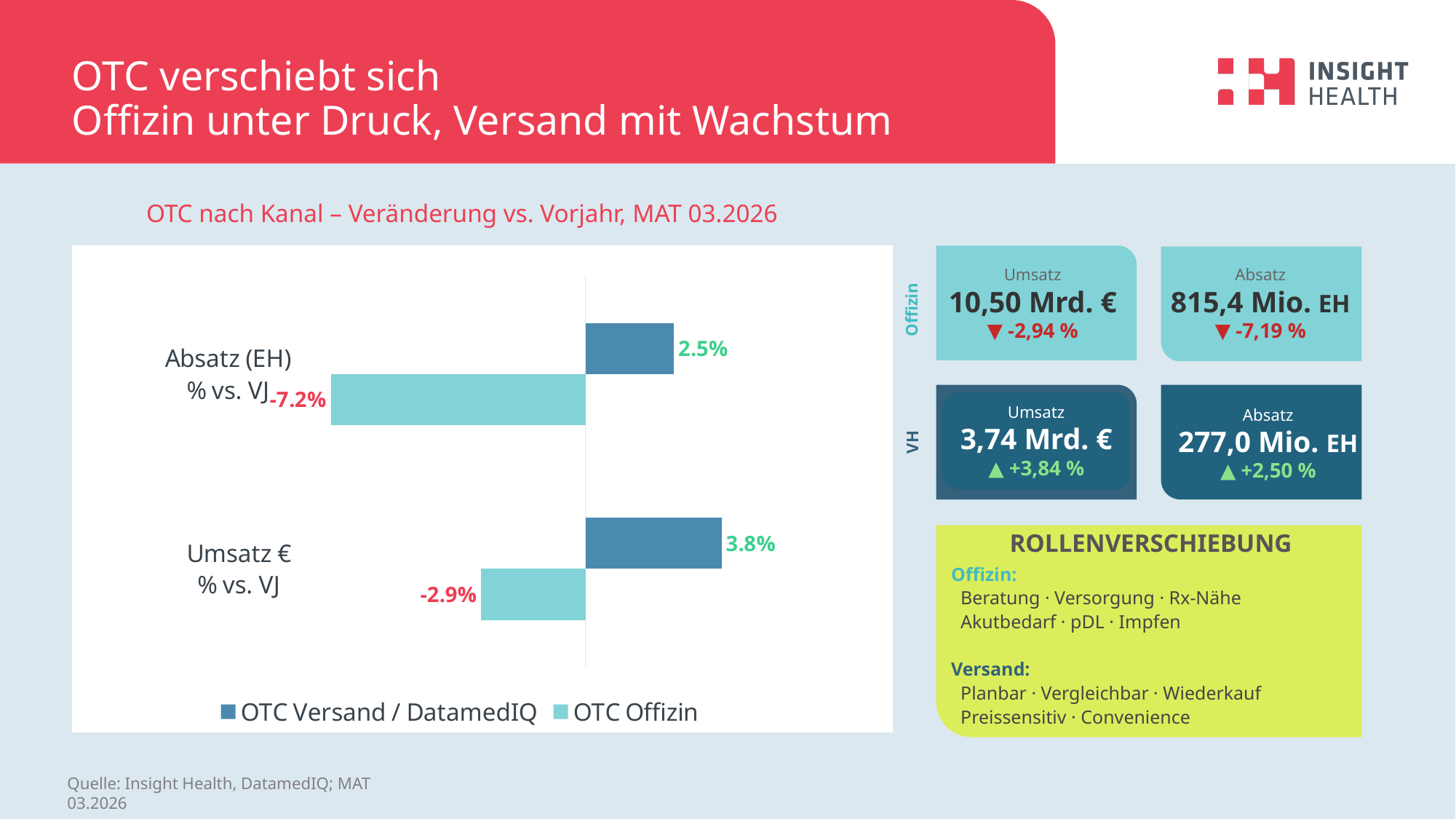
How many categories are shown on the chart? 2 What is the value for OTC Offizin in the Absatz (EH) % vs. VJ category? -7.2% What is the difference between the OTC Versand / DatamedIQ and OTC Offizin values in the Umsatz € % vs. VJ category? 6.7 percentage points Which is larger: the OTC Versand / DatamedIQ value for Absatz (EH) or for Umsatz €? Umsatz € In which category does OTC Versand / DatamedIQ reach its highest value? Umsatz € % vs. VJ What is the value for OTC Versand / DatamedIQ in the Absatz (EH) % vs. VJ category? 2.5% How many series does the legend list? 2 What is the title of the chart? OTC nach Kanal – Veränderung vs. Vorjahr, MAT 03.2026 Which series has the lowest value in the chart? OTC Offizin What is the value for OTC Versand / DatamedIQ in the Umsatz € % vs. VJ category? 3.8% What is the value for OTC Offizin in the Umsatz € % vs. VJ category? -2.9% What kind of chart is shown on the slide? Bar chart